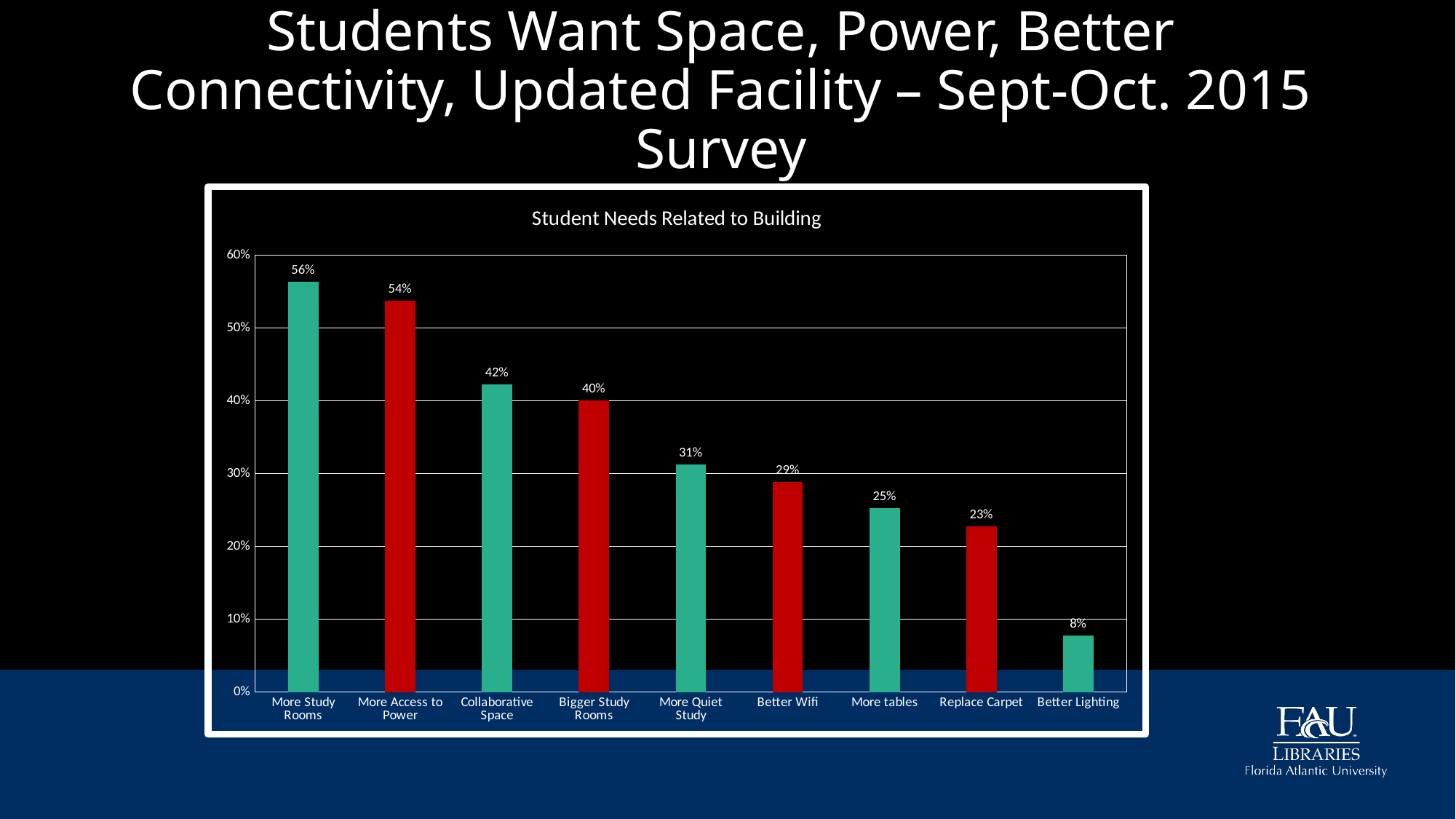
What is the value for Better Wifi? 29% What is the title of the chart? Student Needs Related to Building Is the value for More Access to Power greater or less than 50%? greater How many categories are shown on the x axis? 9 What is the value for More Study Rooms? 56% What is the value for Replace Carpet? 23% What kind of chart is shown on the slide? Bar chart Which category has the lowest value? Better Lighting What is the difference between the values for Collaborative Space and Bigger Study Rooms? 2% Which category has the highest value? More Study Rooms Which is larger, the value for More Quiet Study or the value for More tables? More Quiet Study What is the difference between the values for More Study Rooms and Better Lighting? 48%